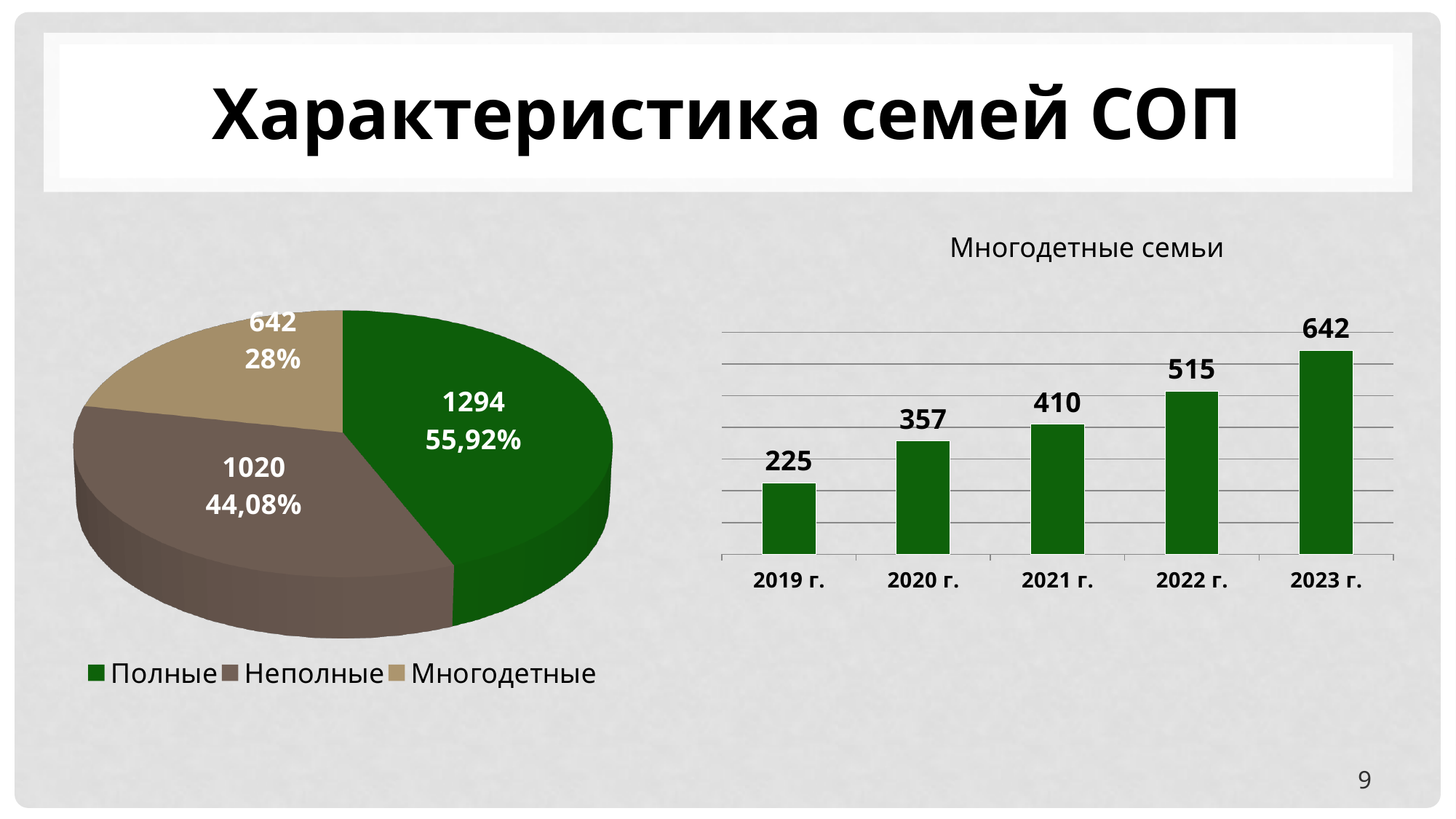
In the chart titled Многодетные семьи, what is the value for 2019 г.? 225 In the chart titled Многодетные семьи, which year has the lowest value? 2019 г. In the chart titled Многодетные семьи, which year has the highest value? 2023 г. In the chart titled Многодетные семьи, what is the value for 2021 г.? 410 In the chart titled Многодетные семьи, do the values rise or fall from 2019 г. to 2023 г.? rise In the pie chart on the left, what percentage is shown for Многодетные? 28% In the pie chart on the left, which category has the largest slice? Полные In the pie chart on the left, what is the difference between the values for Полные and Неполные? 274 In the pie chart on the left, what percentage is shown for Неполные? 44,08% In the pie chart on the left, what value is shown for Полные? 1294 In the pie chart on the left, how many categories does the legend list? 3 In the chart titled Многодетные семьи, what is the difference between the values for 2023 г. and 2022 г.? 127